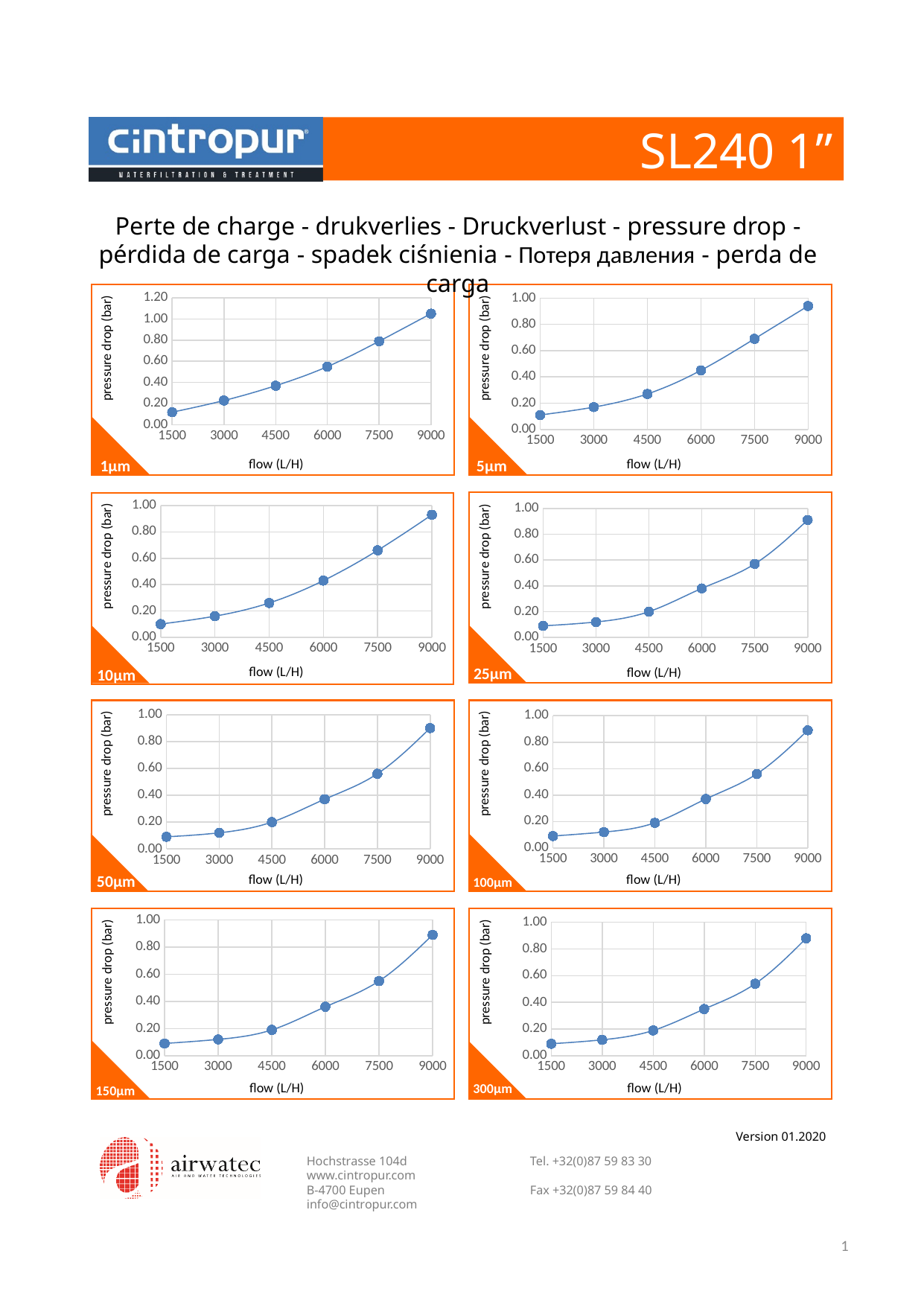
On the 10µm chart, is the pressure drop at 7500 L/H greater or less than 0.60 bar? greater On the 150µm chart, does the pressure drop rise or fall as flow increases from 1500 to 9000 L/H? rises What is the x-axis label on the 1µm chart? flow (L/H) On the 5µm chart, which has the larger pressure drop: 4500 L/H or 7500 L/H? 7500 L/H On the 1µm chart, is the pressure drop at 6000 L/H greater or less than 0.40 bar? greater On the 25µm chart, is the pressure drop at 1500 L/H greater or less than 0.20 bar? less On the 100µm chart, at which flow rate is the pressure drop lowest? 1500 How many data points are plotted on the 5µm chart? 6 On the 50µm chart, at which flow rate is the pressure drop highest? 9000 What kind of chart is the 1µm chart? line chart